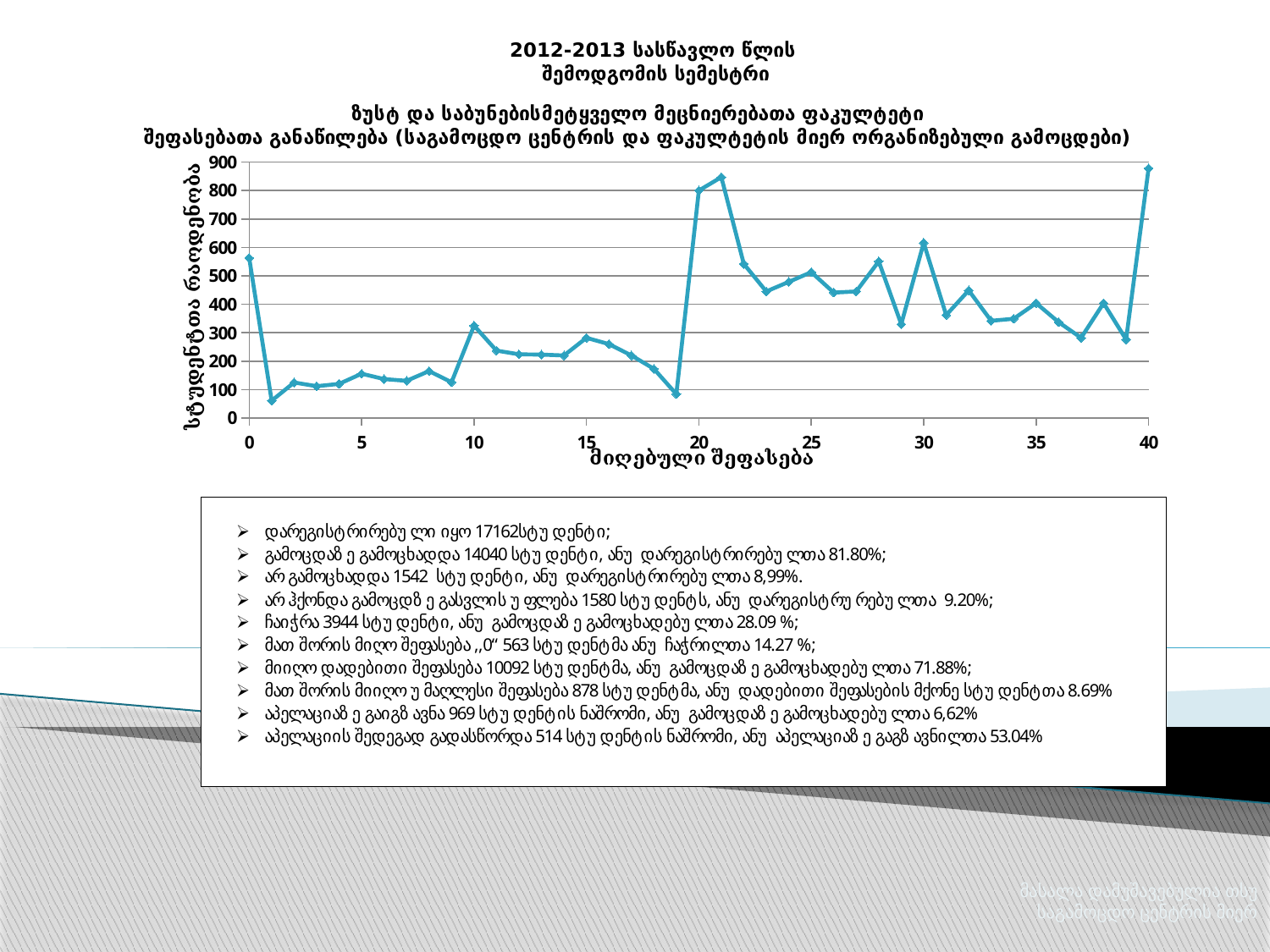
Which is larger, the value at x = 30 or the value at x = 29? x = 30 Is the value at x = 20 greater or less than 700? greater Is the value at x = 1 greater or less than 100? less Is the value at x = 30 greater or less than 500? greater Which is larger, the value at x = 20 or the value at x = 10? x = 20 What kind of chart is shown on the slide? line chart Between x = 10 and x = 19, do the values generally rise or fall? fall What is the label of the x axis? მიღებული შეფასება